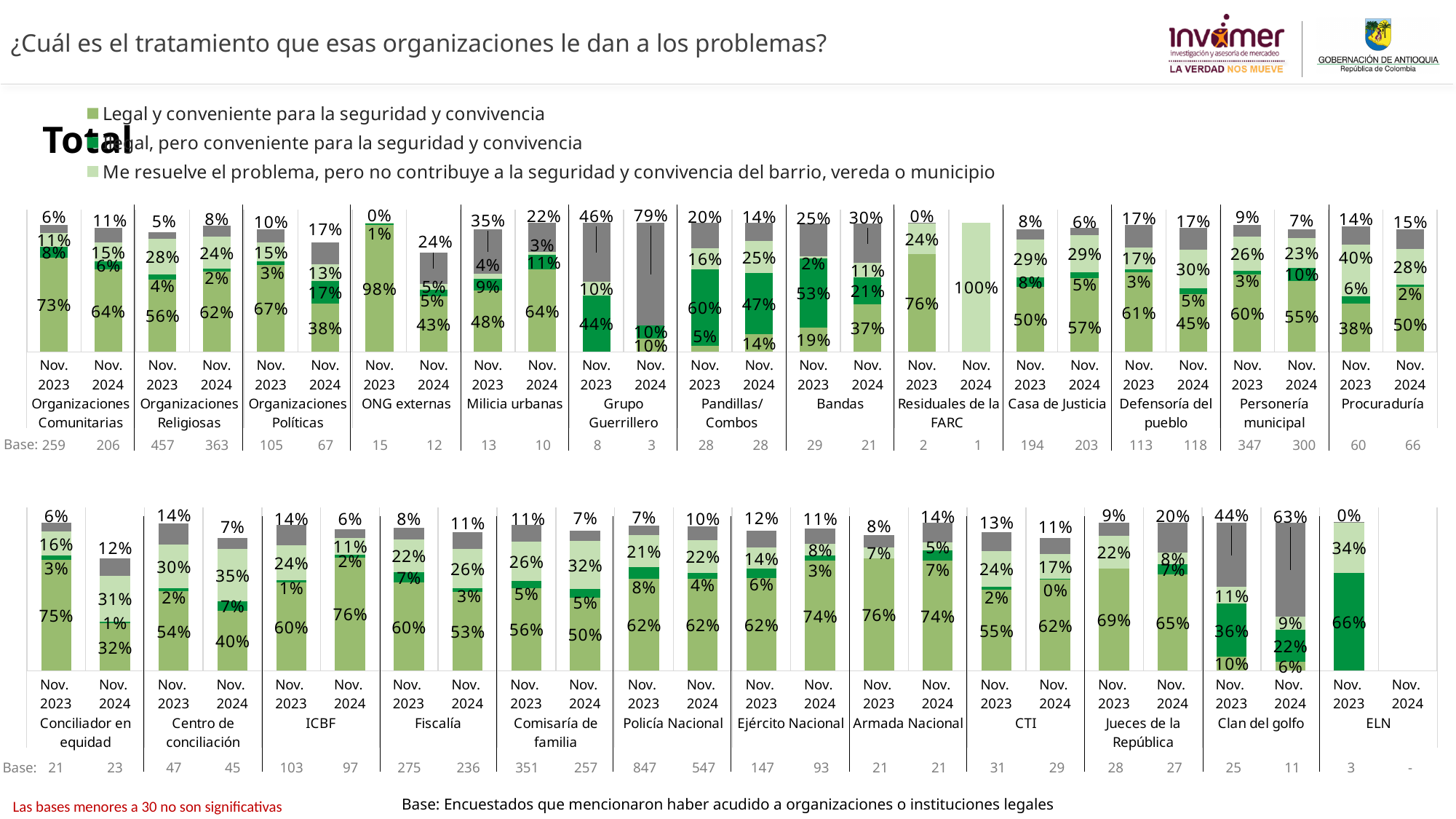
In the bottom chart, what is the 'Legal y conveniente para la seguridad y convivencia' value for ICBF in Nov. 2024? 76% In the top chart, what is the 'Legal y conveniente para la seguridad y convivencia' value for ONG externas in Nov. 2023? 98% How many series does the legend list? 3 In the top chart, what is the 'Legal y conveniente para la seguridad y convivencia' value for Organizaciones Comunitarias in Nov. 2023? 73% In the bottom chart, what is the 'Ilegal, pero conveniente' value for ELN in Nov. 2023? 66% What kind of chart is used on this slide? Stacked bar chart In the bottom chart, what is the base (number of respondents) for Policía Nacional in Nov. 2023? 847 In the top chart, what is the 'Me resuelve el problema' value for Residuales de la FARC in Nov. 2024? 100% In the top chart, by how many percentage points did the 'Legal y conveniente' value for Organizaciones Políticas change from Nov. 2023 (67%) to Nov. 2024 (38%)? 29 percentage points In the bottom chart, what is the 'Me resuelve el problema, pero no contribuye a la seguridad y convivencia del barrio, vereda o municipio' value for Comisaría de familia in Nov. 2024? 32% In the top chart, what is the 'Ilegal, pero conveniente para la seguridad y convivencia' value for Pandillas/Combos in Nov. 2023? 60% In the bottom chart, which is larger: the 'Legal y conveniente' value for Conciliador en equidad in Nov. 2023 or in Nov. 2024? Nov. 2023